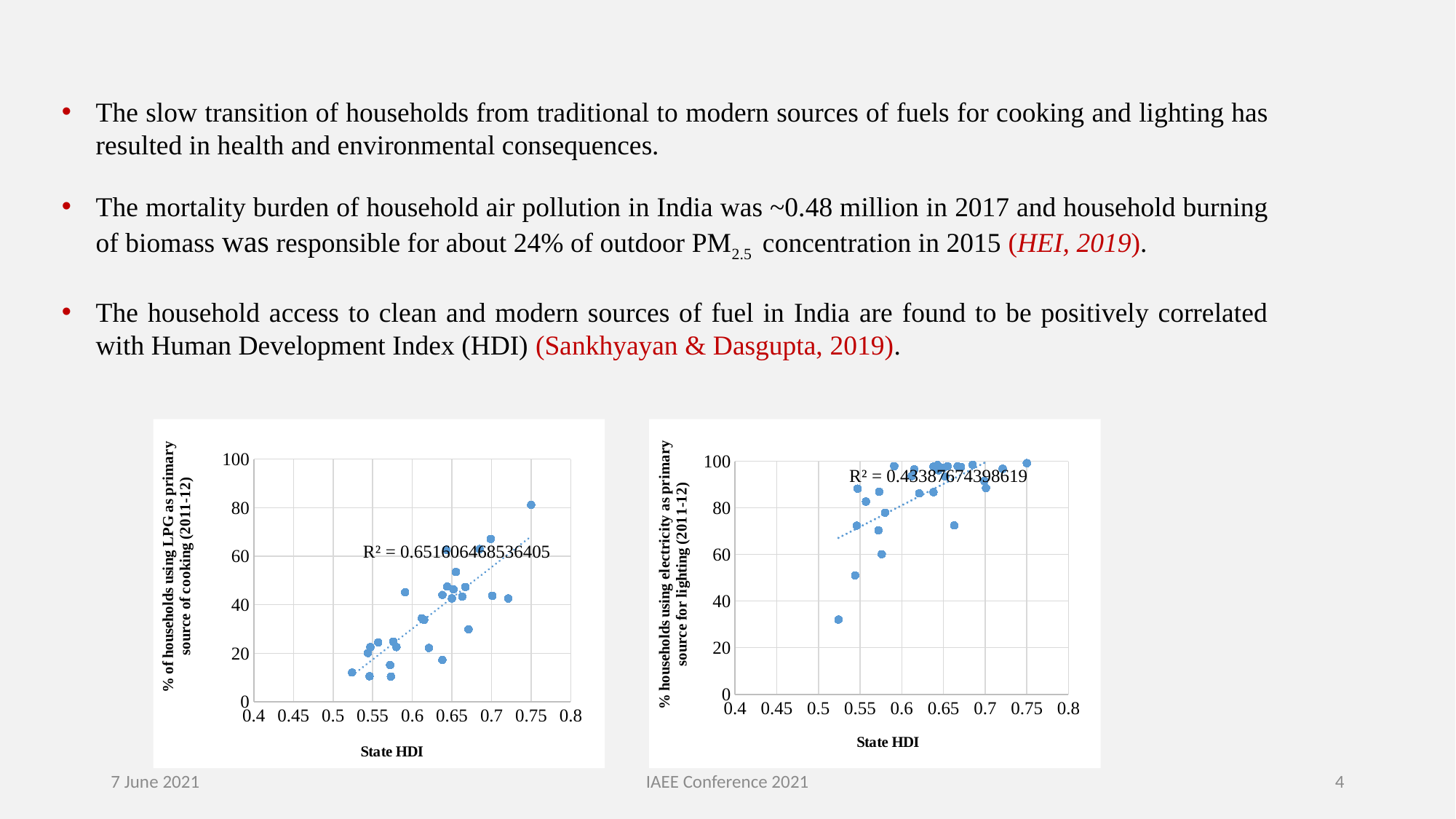
In the right chart, do the plotted values generally rise or fall as State HDI increases? rise In the right chart, is the value for the point at the lowest State HDI (about 0.52) greater or less than 40? less What kind of chart is the right chart on the slide? scatter chart In the left chart, is the value for the point at the lowest State HDI (about 0.52) greater or less than 20? less What kind of chart is the left chart on the slide? scatter chart In the left chart, is the value for the point at the highest State HDI (about 0.75) greater or less than 60? greater In the left chart, do the plotted values generally rise or fall as State HDI increases? rise In the left chart, what is the R² value printed on the chart? R² = 0.651606468536405 Which chart has the higher R² value, the left chart or the right chart? the left chart In the right chart, what is the R² value printed on the chart? R² = 0.43387674398619